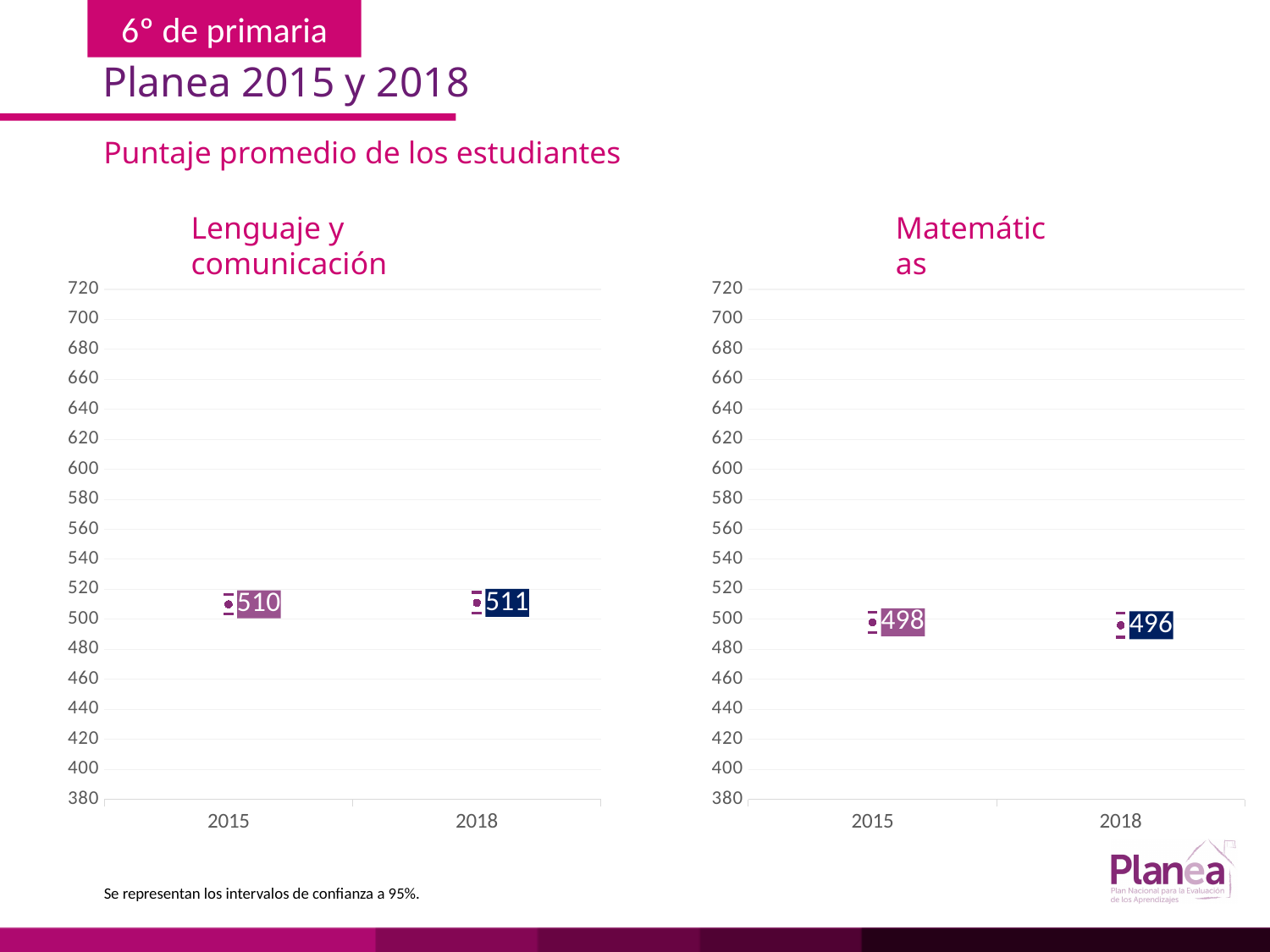
In the 'Matemáticas' chart, do the values rise or fall from 2015 to 2018? fall In the 'Lenguaje y comunicación' chart, what is the difference between the 2018 and 2015 values? 1 What is the title of the chart on the right side of the slide? Matemáticas In the 'Matemáticas' chart, which year has the higher value, 2015 or 2018? 2015 In the 'Matemáticas' chart, what is the difference between the 2015 and 2018 values? 2 In the 'Lenguaje y comunicación' chart, what is the value for 2018? 511 In the 'Lenguaje y comunicación' chart, how many years are shown on the x axis? 2 In the 'Lenguaje y comunicación' chart, which year has the higher value, 2015 or 2018? 2018 In the 'Lenguaje y comunicación' chart, what is the value for 2015? 510 In the 'Matemáticas' chart, is the value for 2018 greater or less than 500? less In the 'Matemáticas' chart, what is the value for 2018? 496 In the 'Matemáticas' chart, what is the value for 2015? 498